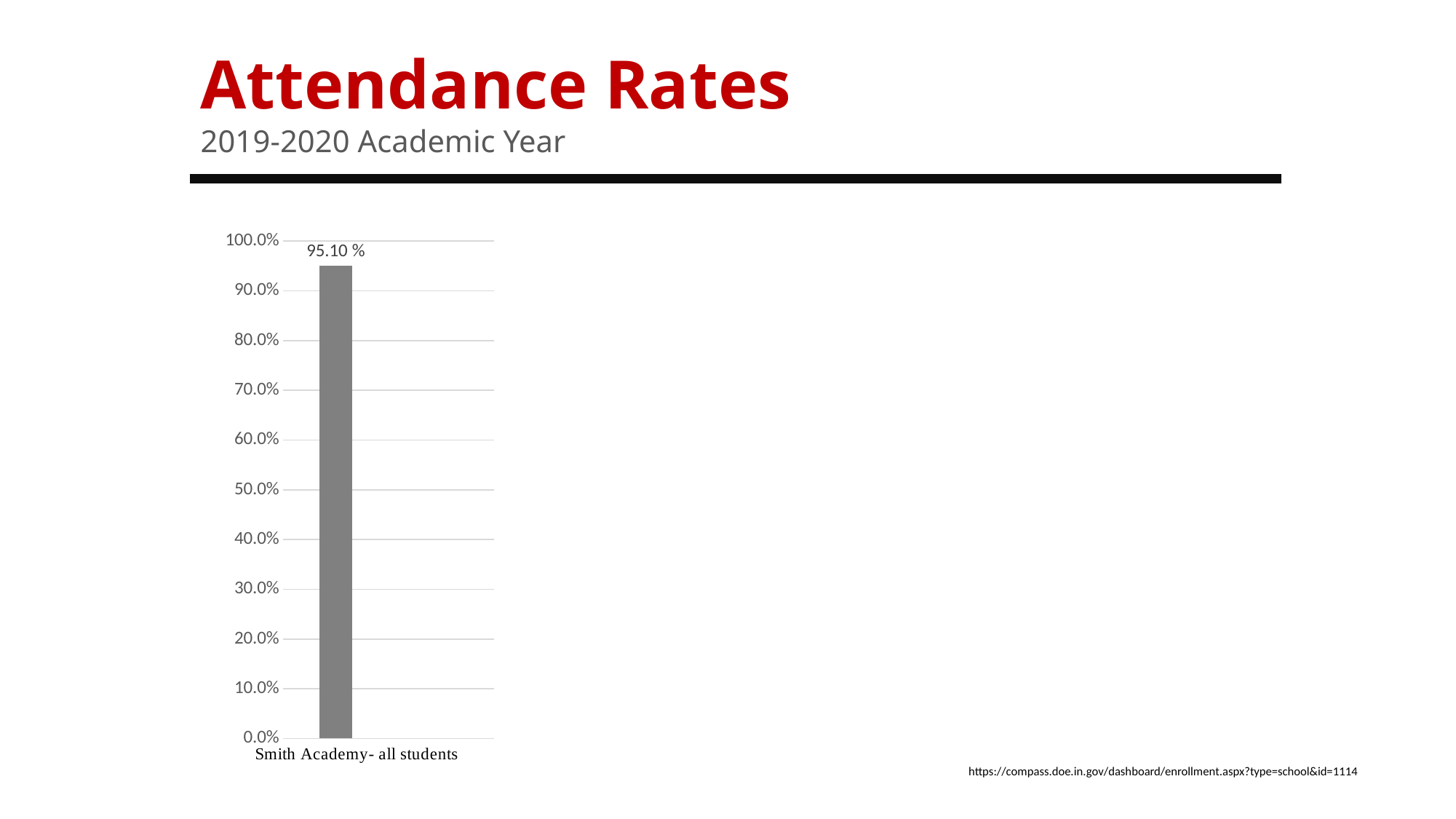
How many bars are plotted in the chart? 1 What is the attendance rate shown for Smith Academy- all students? 95.10 % What kind of chart is shown on the slide? bar chart Is the value for Smith Academy- all students greater or less than 100.0%? less What is the label of the category on the x axis? Smith Academy- all students Is the value for Smith Academy- all students greater or less than 90.0%? greater What is the highest value shown on the y axis? 100.0%